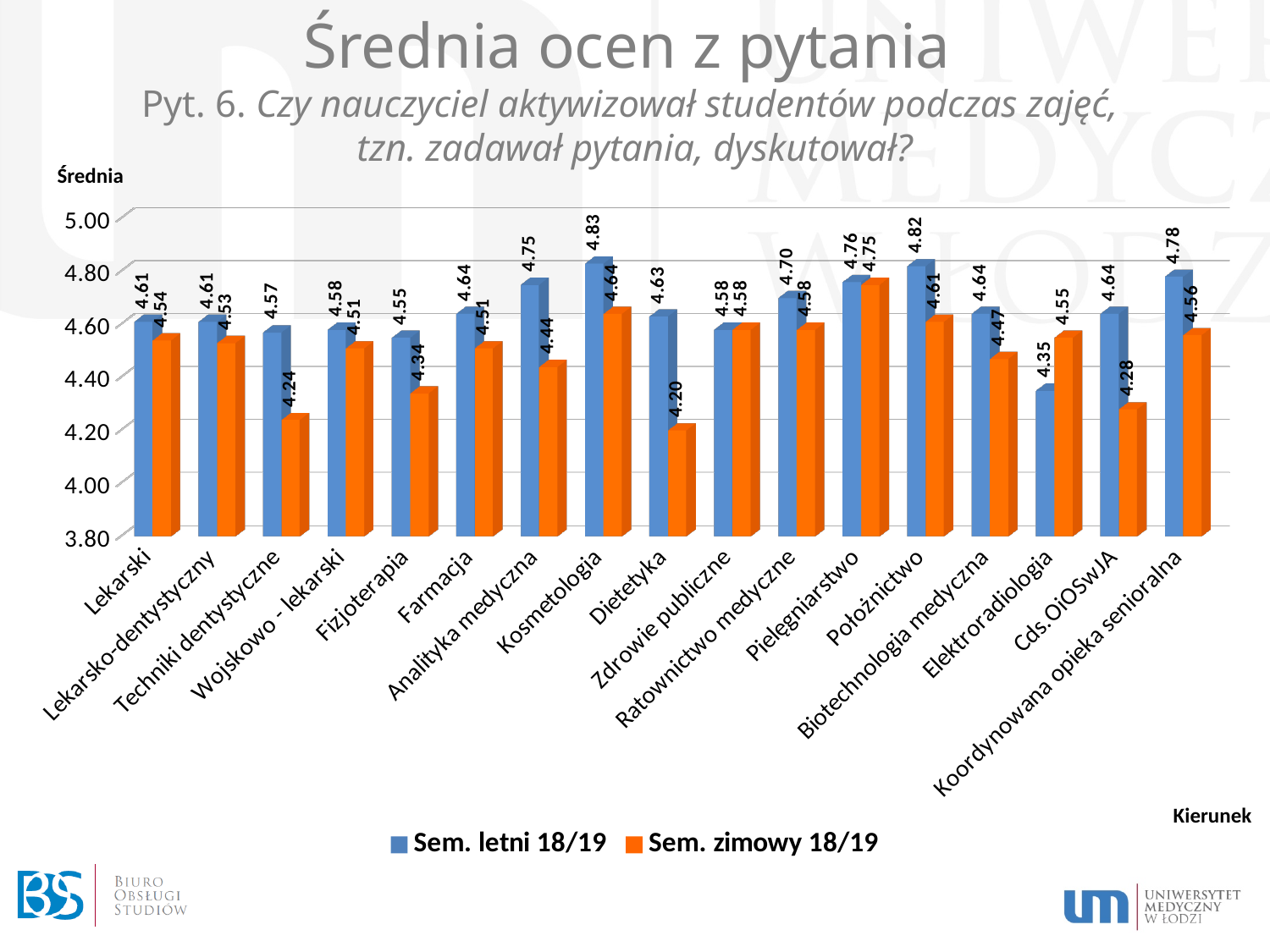
How many categories (kierunki) are shown on the x axis? 17 What is the Sem. zimowy 18/19 value for Dietetyka? 4.20 What kind of chart is shown on the slide? bar chart What is the difference between the Sem. letni 18/19 and Sem. zimowy 18/19 values for Dietetyka? 0.43 Which category has the lowest Sem. zimowy 18/19 value? Dietetyka Which is larger for Elektroradiologia: the Sem. letni 18/19 value or the Sem. zimowy 18/19 value? Sem. zimowy 18/19 Which category has the highest Sem. letni 18/19 value? Kosmetologia Which category has the lowest Sem. letni 18/19 value? Elektroradiologia How many series does the legend list? 2 What is the Sem. zimowy 18/19 value for Pielęgniarstwo? 4.75 Is the Sem. zimowy 18/19 value for Techniki dentystyczne greater or less than 4.40? less What is the Sem. letni 18/19 value for Kosmetologia? 4.83